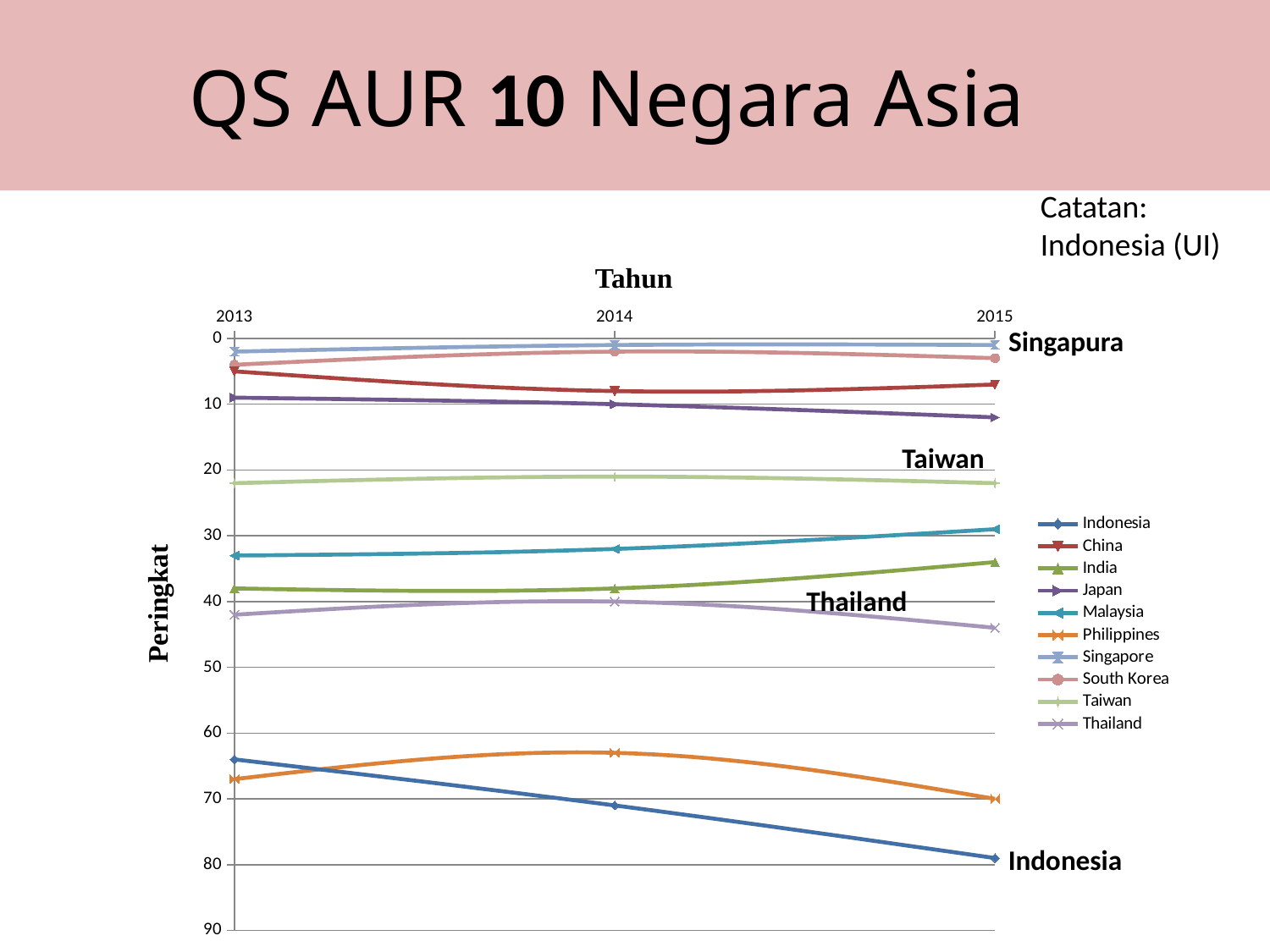
Is the value for India in 2013 greater or less than 40? less Is the value for Thailand in 2015 greater or less than 40? greater Is the value for Indonesia in 2015 greater or less than 70? greater How many series does the legend list? 10 What is the title of the y axis? Peringkat Does the plotted value for Indonesia rise or fall from 2013 to 2015? rise Which series has the highest plotted value in 2015? Indonesia In 2015, which has the larger plotted value, Indonesia or Philippines? Indonesia What kind of chart is shown on the slide? line chart How many years are shown on the x axis? 3